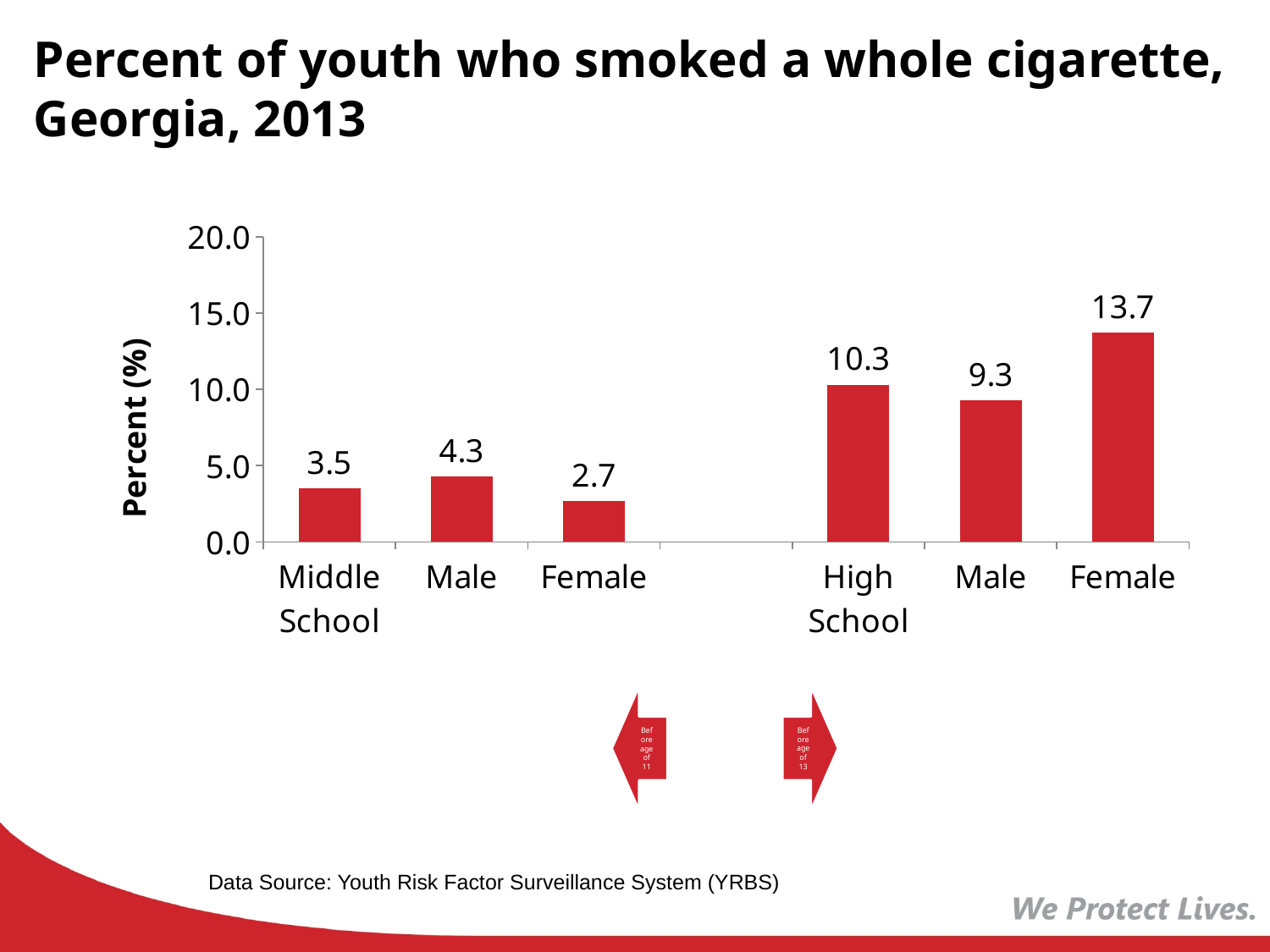
What is the difference between the High School value and the Middle School value? 6.8 What is the value for Middle School? 3.5 What kind of chart is shown on the slide? bar chart What is the difference between the High School Female and High School Male values? 4.4 What is the value for High School Female? 13.7 What is the value for Middle School Male? 4.3 Which category has the highest value? High School Female Is the value for High School greater or less than 10.0? greater What is the value for High School Male? 9.3 Which is larger, the Middle School Male value or the Middle School Female value? Middle School Male How many bars are plotted in the chart? 6 Which category has the lowest value? Middle School Female